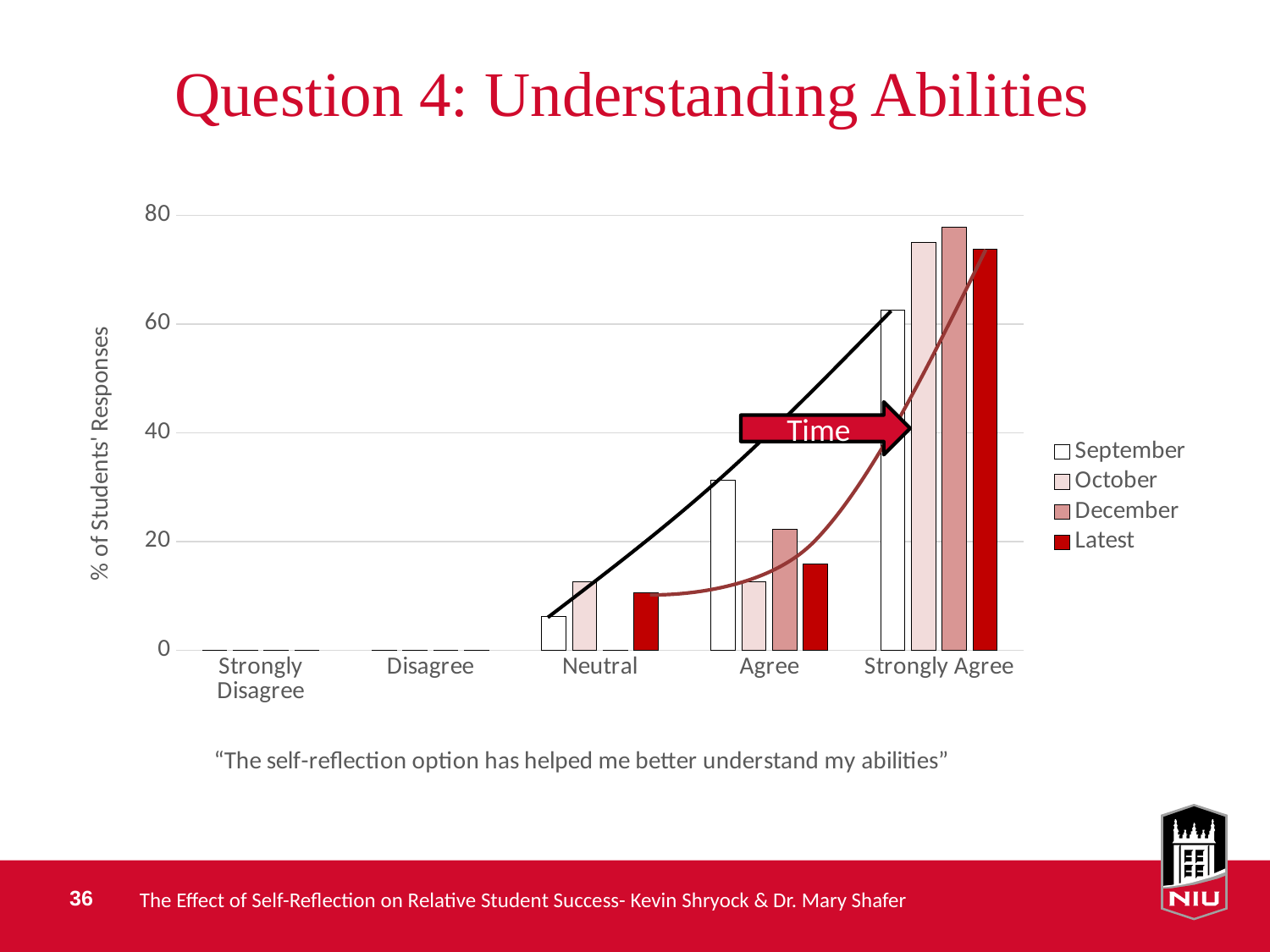
Which response category has the highest September value? Strongly Agree How many response categories are shown on the x axis? 5 Is the Latest value for Agree greater or less than 20? less How many series does the legend list? 4 Is the December value for Strongly Agree greater or less than 60? greater Is the September value for Agree greater or less than 20? greater What kind of chart is shown on the slide? bar chart Which response category has the highest Latest value? Strongly Agree For Strongly Agree, which is larger: the September value or the December value? December What is the label on the vertical axis of the chart? % of Students' Responses For Agree, which is larger: the September value or the December value? September